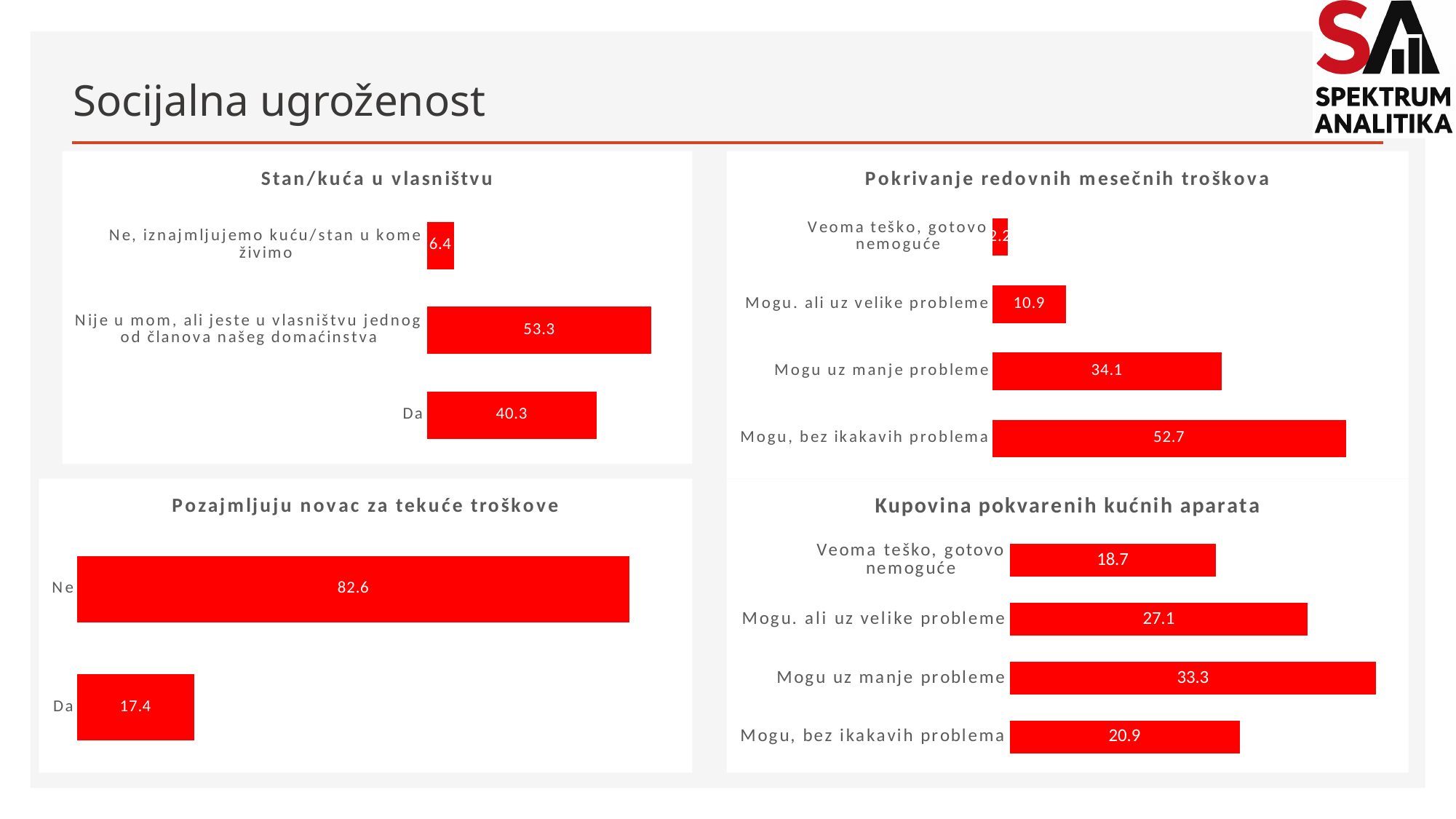
In the chart titled "Pokrivanje redovnih mesečnih troškova", which category has the lowest value? Veoma teško, gotovo nemoguće In the chart titled "Kupovina pokvarenih kućnih aparata", what is the value for "Mogu, bez ikakavih problema"? 20.9 What type of chart is the chart titled "Pozajmljuju novac za tekuće troškove"? Bar chart In the chart titled "Stan/kuća u vlasništvu", which category has the highest value? Nije u mom, ali jeste u vlasništvu jednog od članova našeg domaćinstva In the chart titled "Pozajmljuju novac za tekuće troškove", what is the difference between the values for "Ne" and "Da"? 65.2 In the chart titled "Stan/kuća u vlasništvu", what is the difference between the values for "Nije u mom, ali jeste u vlasništvu jednog od članova našeg domaćinstva" and "Da"? 13.0 In the chart titled "Kupovina pokvarenih kućnih aparata", which is larger: the value for "Mogu. ali uz velike probleme" or the value for "Veoma teško, gotovo nemoguće"? Mogu. ali uz velike probleme In the chart titled "Pokrivanje redovnih mesečnih troškova", how many categories are shown? 4 In the chart titled "Stan/kuća u vlasništvu", what is the value for "Da"? 40.3 In the chart titled "Pozajmljuju novac za tekuće troškove", what is the value for "Da"? 17.4 In the chart titled "Pokrivanje redovnih mesečnih troškova", what is the value for "Mogu uz manje probleme"? 34.1 In the chart titled "Kupovina pokvarenih kućnih aparata", which category has the highest value? Mogu uz manje probleme